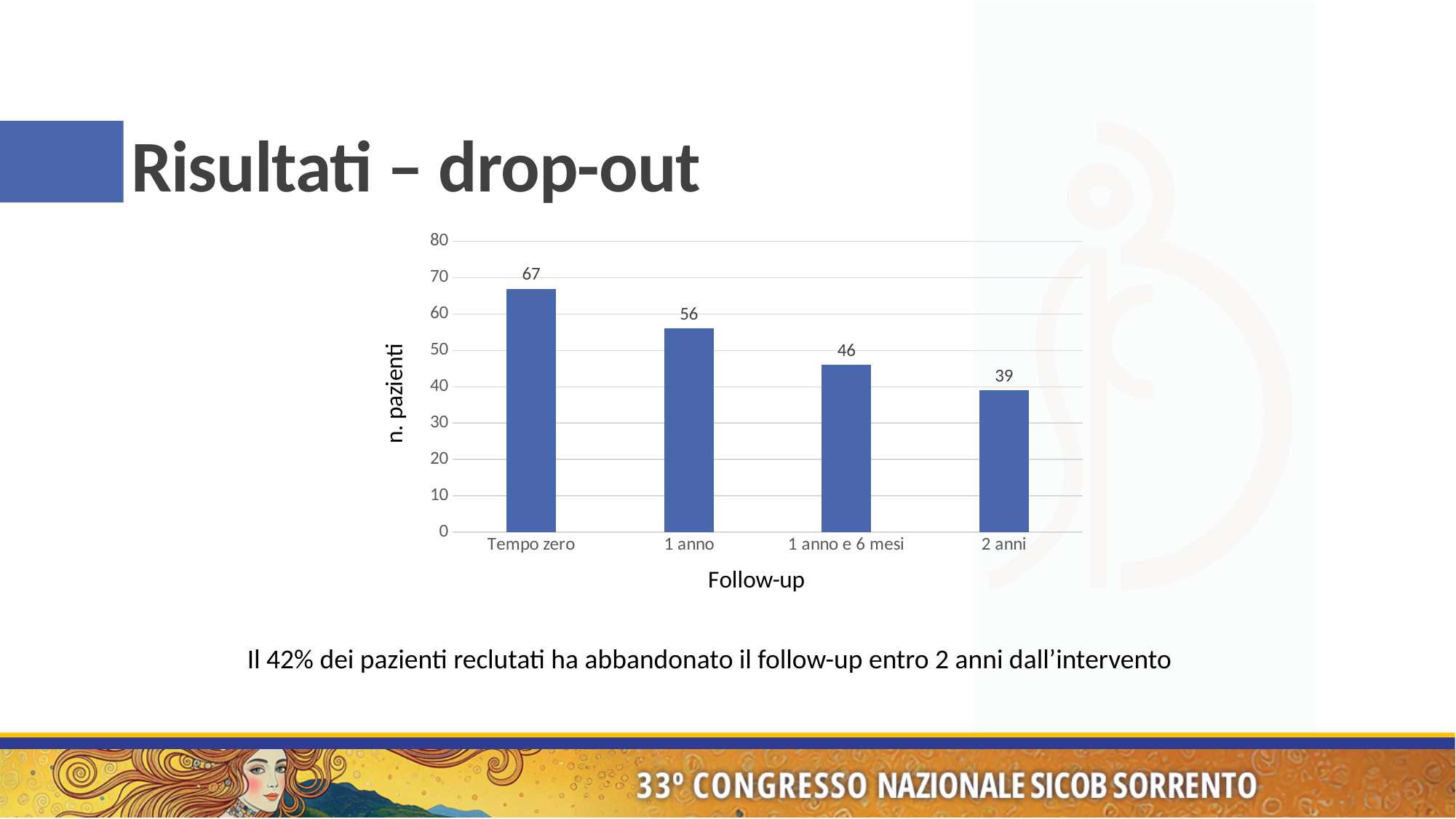
What is the number of patients at 1 anno e 6 mesi? 46 What is the number of patients at 2 anni? 39 What is the difference in number of patients between 1 anno and 1 anno e 6 mesi? 10 Which follow-up point has the highest number of patients? Tempo zero How many follow-up categories are shown on the x axis? 4 What is the number of patients at Tempo zero? 67 Which follow-up point has the lowest number of patients? 2 anni What is the number of patients at 1 anno? 56 What kind of chart is shown on the slide? Bar chart What is the difference in number of patients between Tempo zero and 2 anni? 28 Do the values rise or fall from Tempo zero to 2 anni? Fall Which has more patients, 1 anno or 2 anni? 1 anno